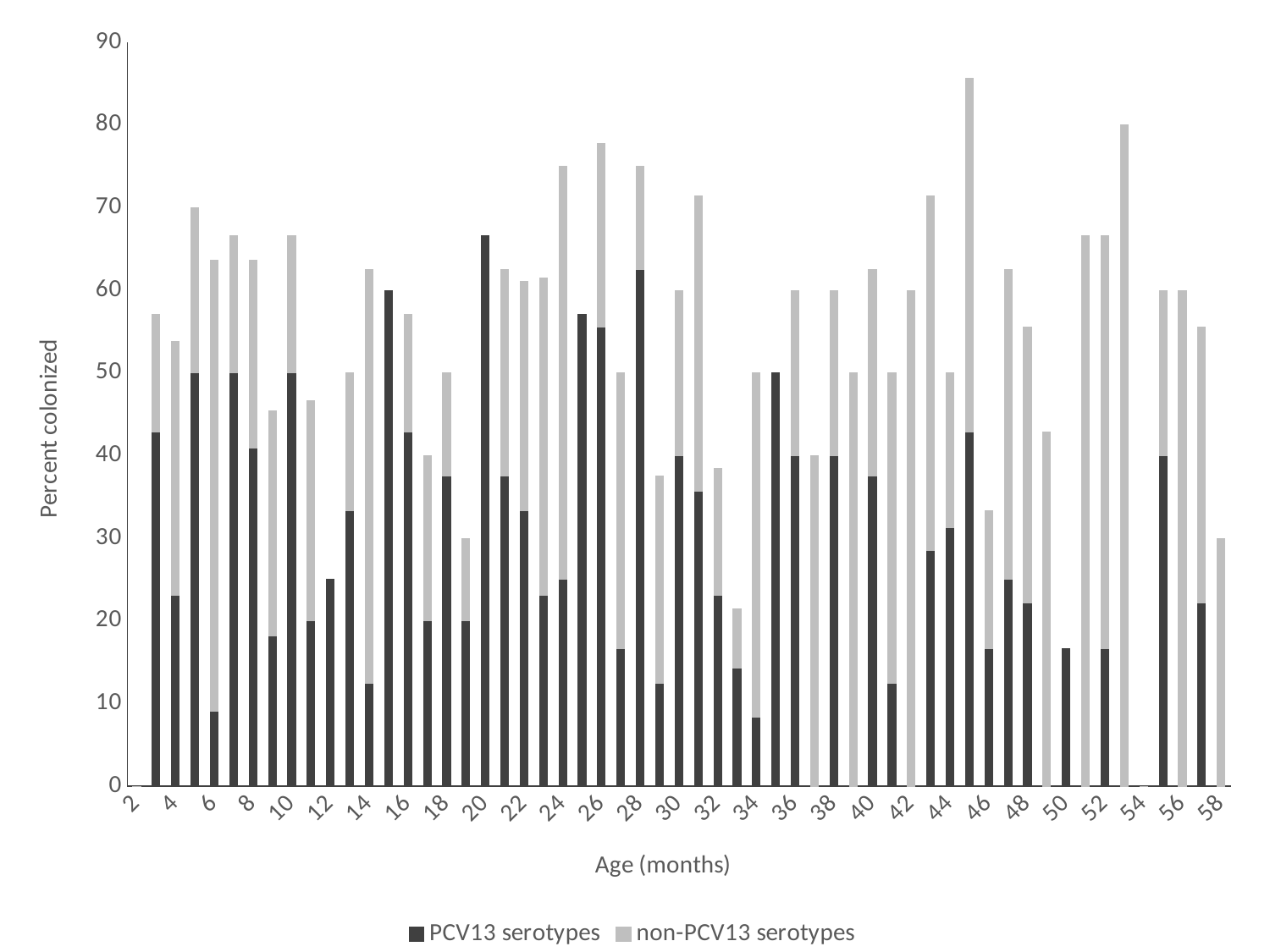
Which has the larger PCV13 serotypes value: age 14 months or age 8 months? 8 months Is the total height of the stacked bar at age 58 months greater or less than 40? less What is the title of the vertical axis? Percent colonized How many series does the legend list? 2 Is the PCV13 serotypes value at age 34 months greater or less than 10? less Which has the taller total stacked bar: age 24 months or age 32 months? 24 months What kind of chart is shown on the slide? Stacked bar chart Is the total height of the stacked bar at age 4 months greater or less than 60? less At which age (months) is the total stacked bar the tallest? 45 What are the two series named in the legend? PCV13 serotypes and non-PCV13 serotypes